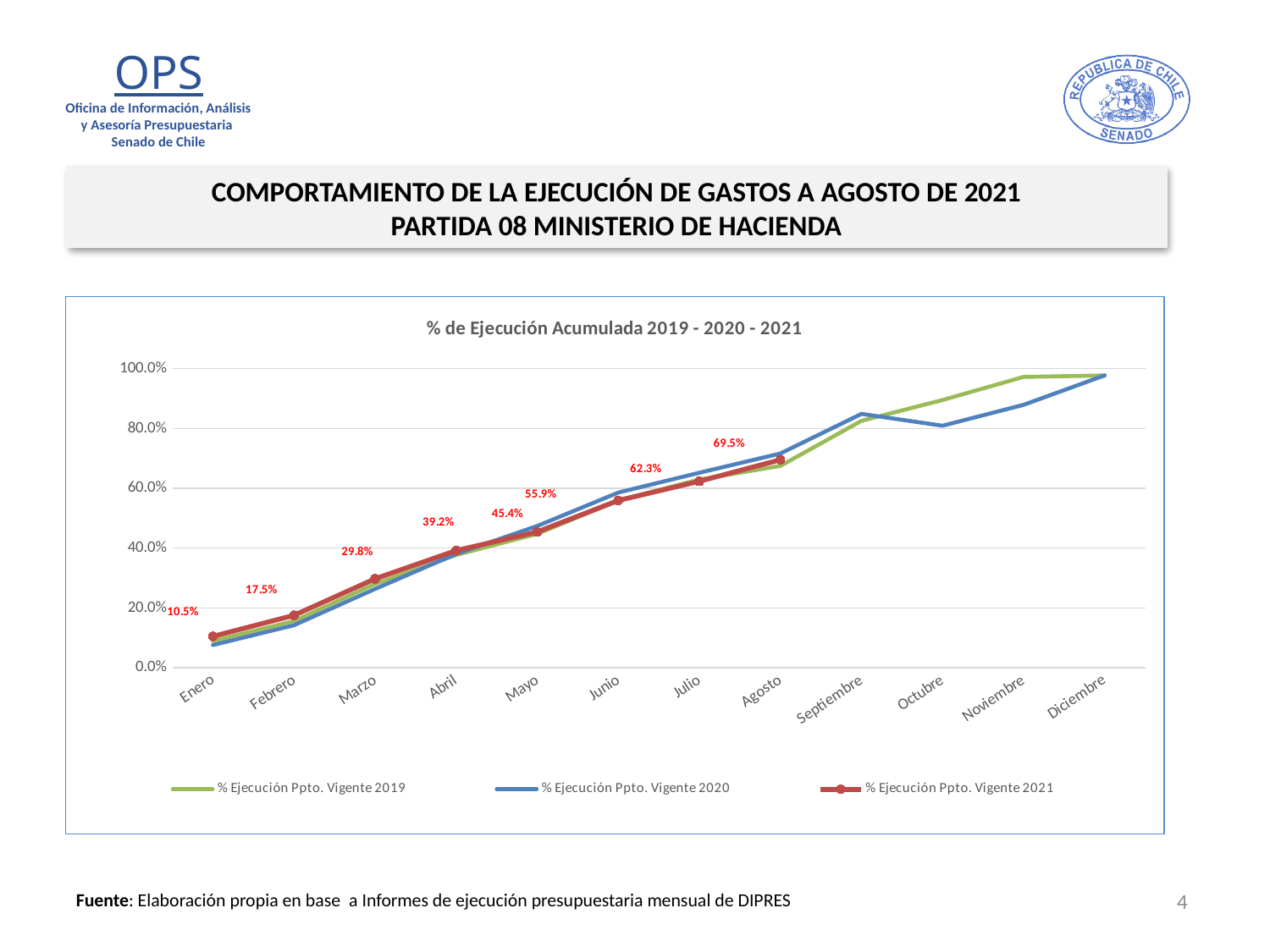
What is the value for Enero in the % Ejecución Ppto. Vigente 2021 series? 10.5% What is the value for Marzo in the % Ejecución Ppto. Vigente 2021 series? 29.8% How many months are shown on the x axis? 12 What is the value for Agosto in the % Ejecución Ppto. Vigente 2021 series? 69.5% Which month has the lowest labelled value in the % Ejecución Ppto. Vigente 2021 series? Enero Is the value for Noviembre in the % Ejecución Ppto. Vigente 2019 series greater or less than 80.0%? greater What kind of chart is shown on the slide? Line chart How many series does the legend list? 3 Which month has the highest labelled value in the % Ejecución Ppto. Vigente 2021 series? Agosto Do the values of the % Ejecución Ppto. Vigente 2021 series rise or fall from Enero to Agosto? Rise What is the difference between the Agosto and Julio values in the % Ejecución Ppto. Vigente 2021 series? 7.2 percentage points What is the title of the chart? % de Ejecución Acumulada 2019 - 2020 - 2021